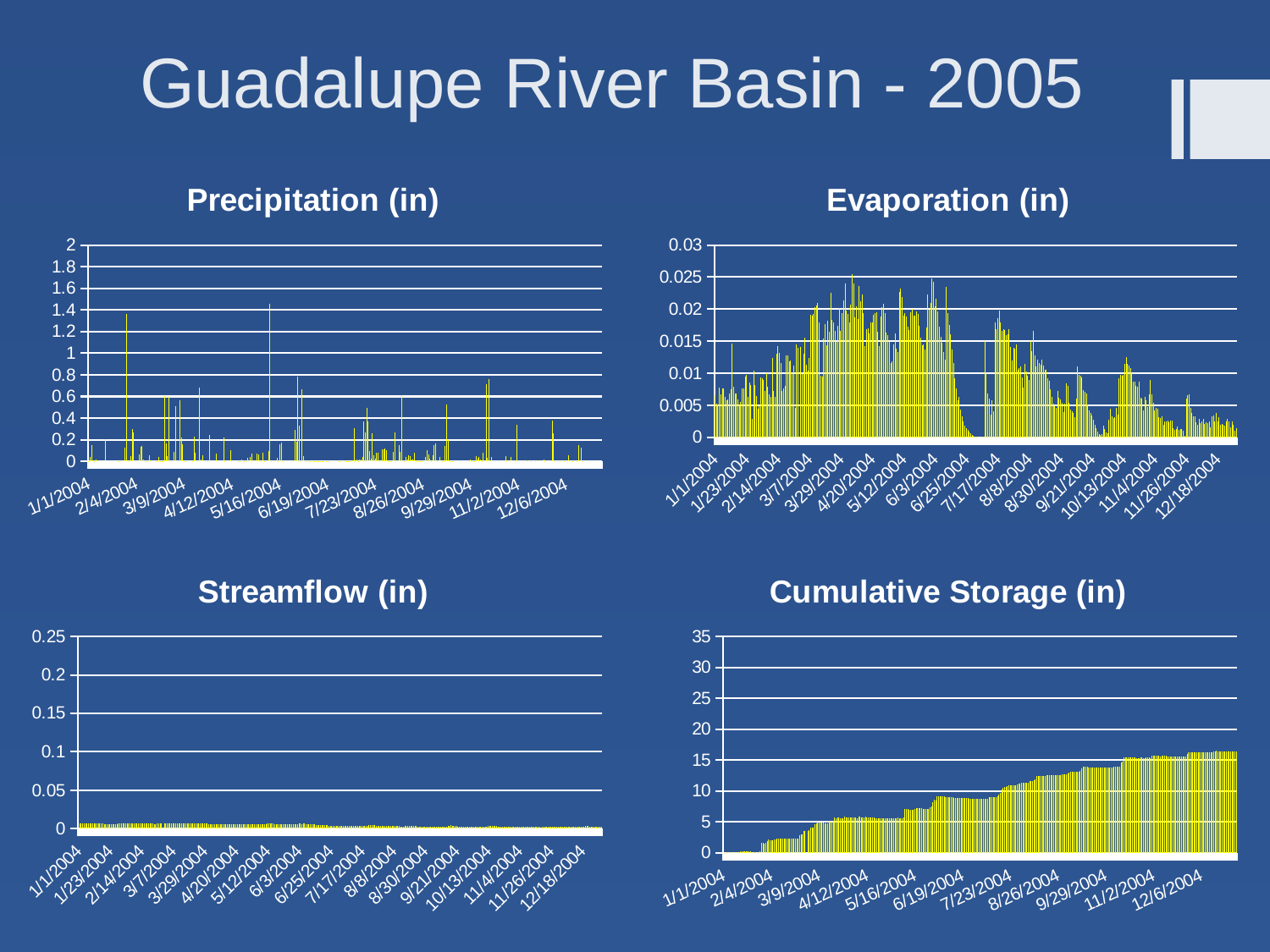
How many charts are shown on the slide? 4 In the Cumulative Storage (in) chart, is the value at 4/12/2004 greater or less than 10? less In the Precipitation (in) chart, is the tallest spike near 5/16/2004 greater or less than 1? greater Which chart on the slide has a y-axis that goes up to 35? Cumulative Storage (in) What kind of chart is the Cumulative Storage (in) chart? bar chart In the Cumulative Storage (in) chart, do the values rise or fall from 1/1/2004 to 12/6/2004? rise In the Streamflow (in) chart, is the value at 1/1/2004 greater or less than 0.05? less What kind of chart is the Precipitation (in) chart? bar chart